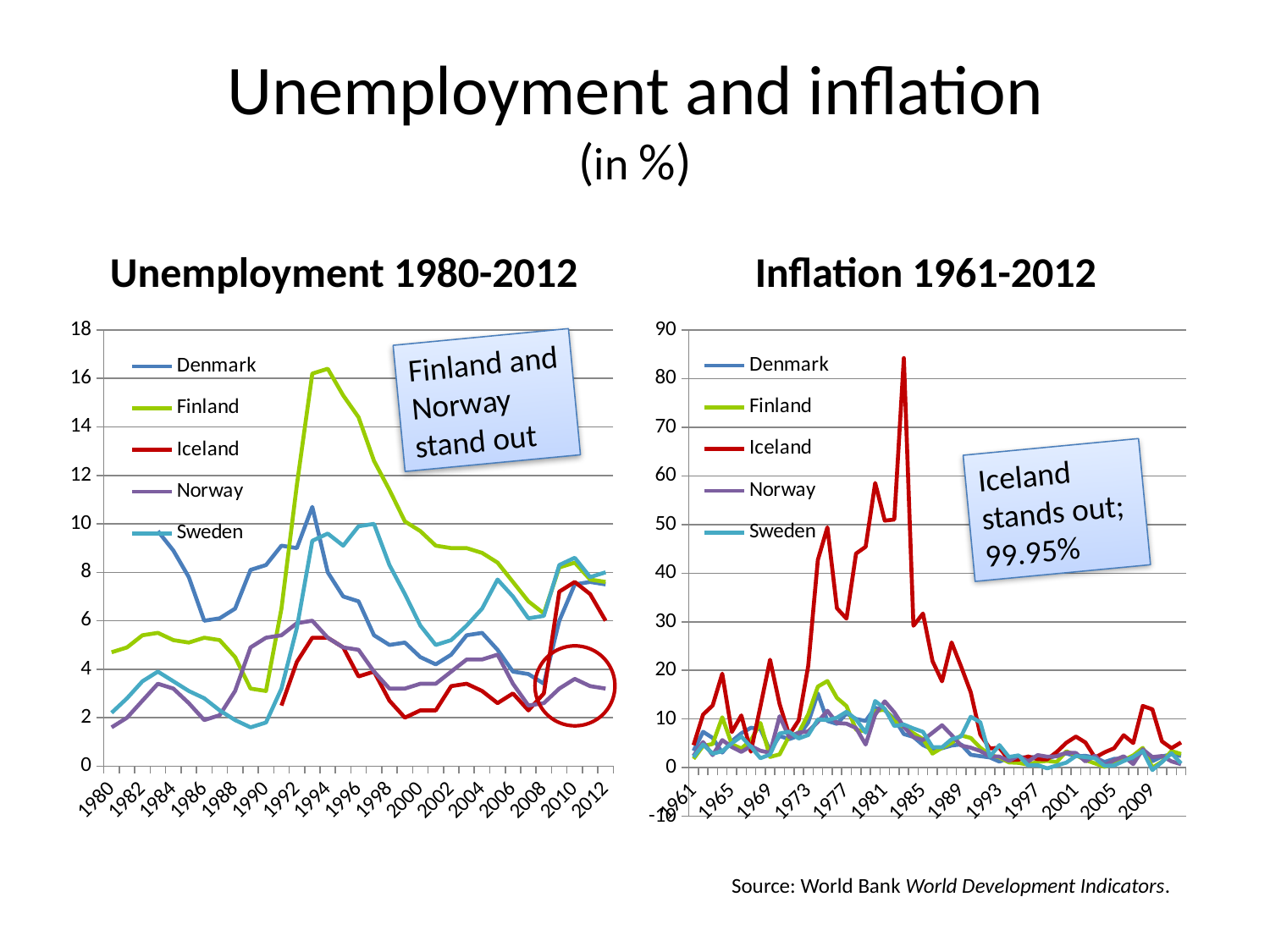
In the 'Inflation 1961-2012' chart, is Iceland's peak inflation in 1983 greater or less than 80? greater What kind of chart is the 'Unemployment 1980-2012' chart? line chart In the 'Inflation 1961-2012' chart, which country reaches the highest inflation rate? Iceland In the 'Inflation 1961-2012' chart, does Iceland's inflation rise or fall between 1983 and 1993? fall In the 'Unemployment 1980-2012' chart, is Finland's unemployment in 1994 greater or less than 14? greater What percentage is given in the annotation on the 'Inflation 1961-2012' chart saying Iceland stands out? 99.95% In the 'Inflation 1961-2012' chart, which is larger in 1983: Iceland's or Denmark's inflation? Iceland In the 'Unemployment 1980-2012' chart, does Finland's unemployment rise or fall between 1994 and 2008? fall In the 'Unemployment 1980-2012' chart, which country reaches the highest unemployment rate? Finland In the 'Unemployment 1980-2012' chart, is Sweden's unemployment in 1990 greater or less than 4? less In the 'Unemployment 1980-2012' chart, which is larger in 1994: Finland's or Iceland's unemployment? Finland How many series does the legend of the 'Inflation 1961-2012' chart list? 5